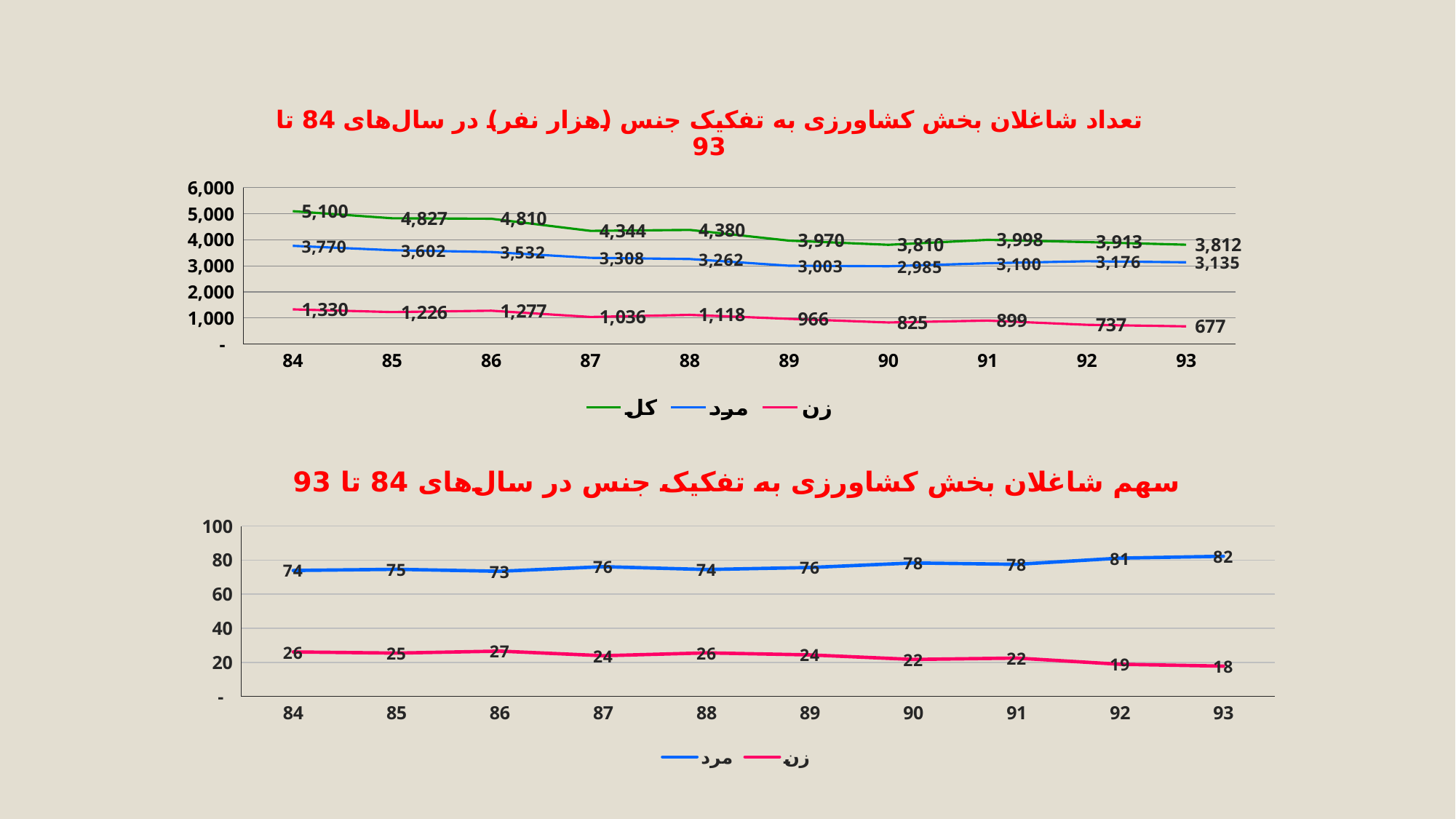
In the bottom chart, what is the value of the زن series for year 86? 27 In the top chart, what is the value of the کل series for year 84? 5,100 In the top chart, what is the difference between the کل values for years 84 and 93? 1,288 What kind of chart is the bottom chart? line chart How many years are shown on the x axis of the bottom chart? 10 In the top chart, what is the value of the مرد series for year 90? 2,985 In the bottom chart, what is the value of the مرد series for year 93? 82 In the top chart, in which year is the زن series lowest? 93 In the bottom chart, does the زن series generally rise or fall from year 84 to year 93? fall How many series does the legend of the top chart list? 3 In the top chart, what is the value of the زن series for year 93? 677 In the top chart, in which year is the کل series highest? 84